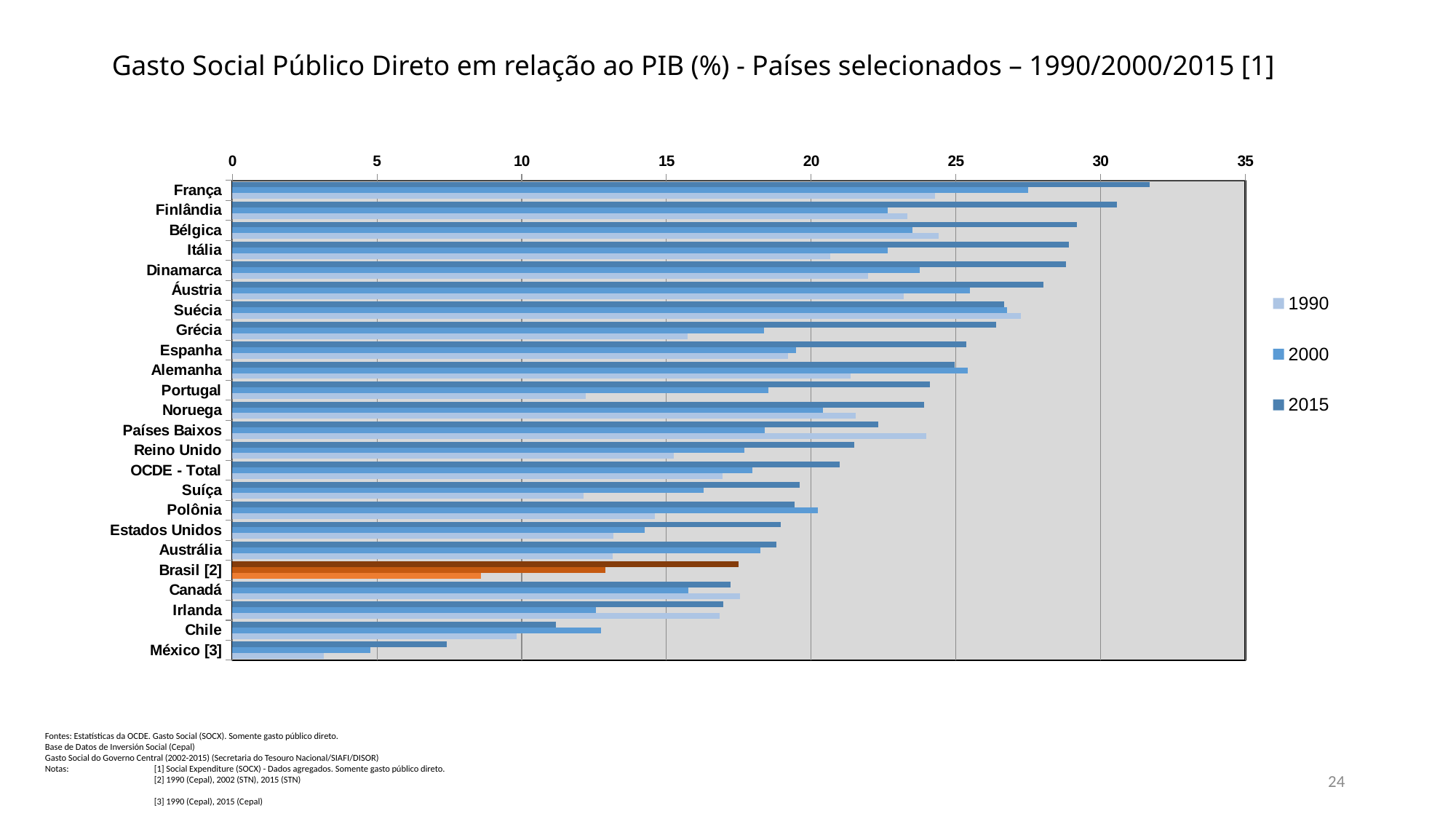
What kind of chart is shown on the slide? bar chart Which category has the highest value for 1990? Suécia Is the 1990 value for Países Baixos greater or less than 25? less How many series does the legend list? 3 Which category has the lowest value for 2015? México [3] Which is larger: the 2015 value for Chile or the 2015 value for México [3]? Chile Which category has the lowest value for 1990? México [3] Is the 2015 value for França greater or less than 30? greater Which category has the highest value for 2015? França Which category's bars are highlighted in orange rather than blue? Brasil [2] How many countries/categories are plotted on the chart? 24 Is the 2015 value for Brasil [2] greater or less than 20? less